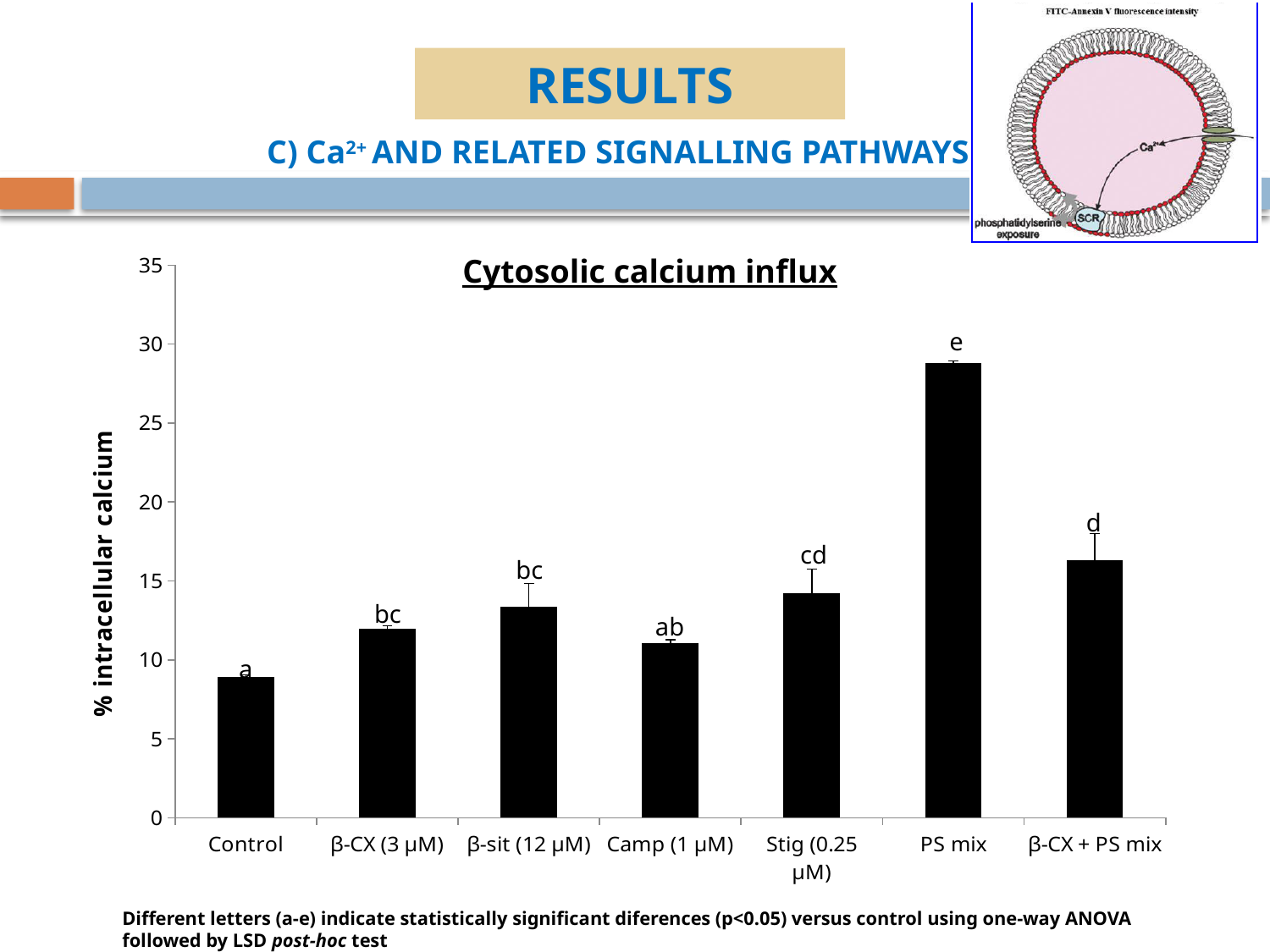
Is the value for Camp (1 µM) greater or less than 15? less Is the value for β-CX + PS mix greater or less than 15? greater What is the label on the y axis of the chart? % intracellular calcium Which category has the highest % intracellular calcium? PS mix Which is larger, the value for Control or the value for Camp (1 µM)? Camp (1 µM) Is the value for PS mix greater or less than 25? greater Which is larger, the value for PS mix or the value for β-CX + PS mix? PS mix What is the title of the chart? Cytosolic calcium influx Which category has the lowest % intracellular calcium? Control How many categories (bars) are plotted in the chart? 7 What type of chart is shown on the slide? Bar chart